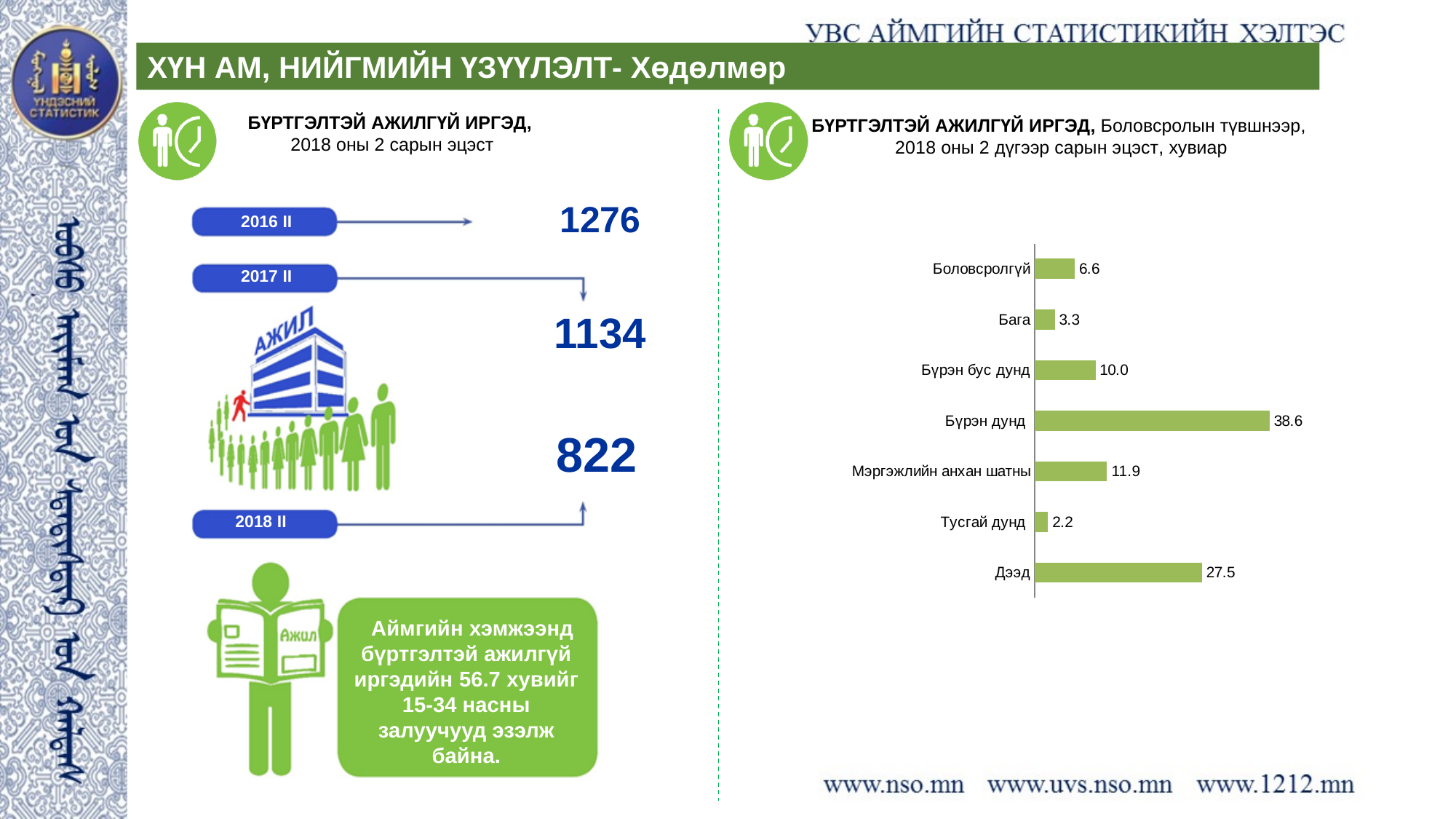
In the bar chart on the right, what is the difference between the values for Бүрэн дунд and Дээд? 11.1 How many categories are shown in the bar chart on the right? 7 In the infographic on the left, what is the value shown for 2018 II? 822 In the bar chart on the right, what is the value for Бага? 3.3 In the bar chart on the right, which category has the highest value? Бүрэн дунд In the bar chart on the right, what is the difference between the values for Мэргэжлийн анхан шатны and Бүрэн бус дунд? 1.9 In the bar chart on the right, what is the value for Бүрэн дунд? 38.6 In the bar chart on the right, which category has the lowest value? Тусгай дунд In the bar chart on the right, which is larger: the value for Дээд or the value for Мэргэжлийн анхан шатны? Дээд In the bar chart on the right, what is the value for Дээд? 27.5 What kind of chart is shown on the right side of the slide? Bar chart In the infographic on the left, what is the difference between the values for 2016 II and 2018 II? 454